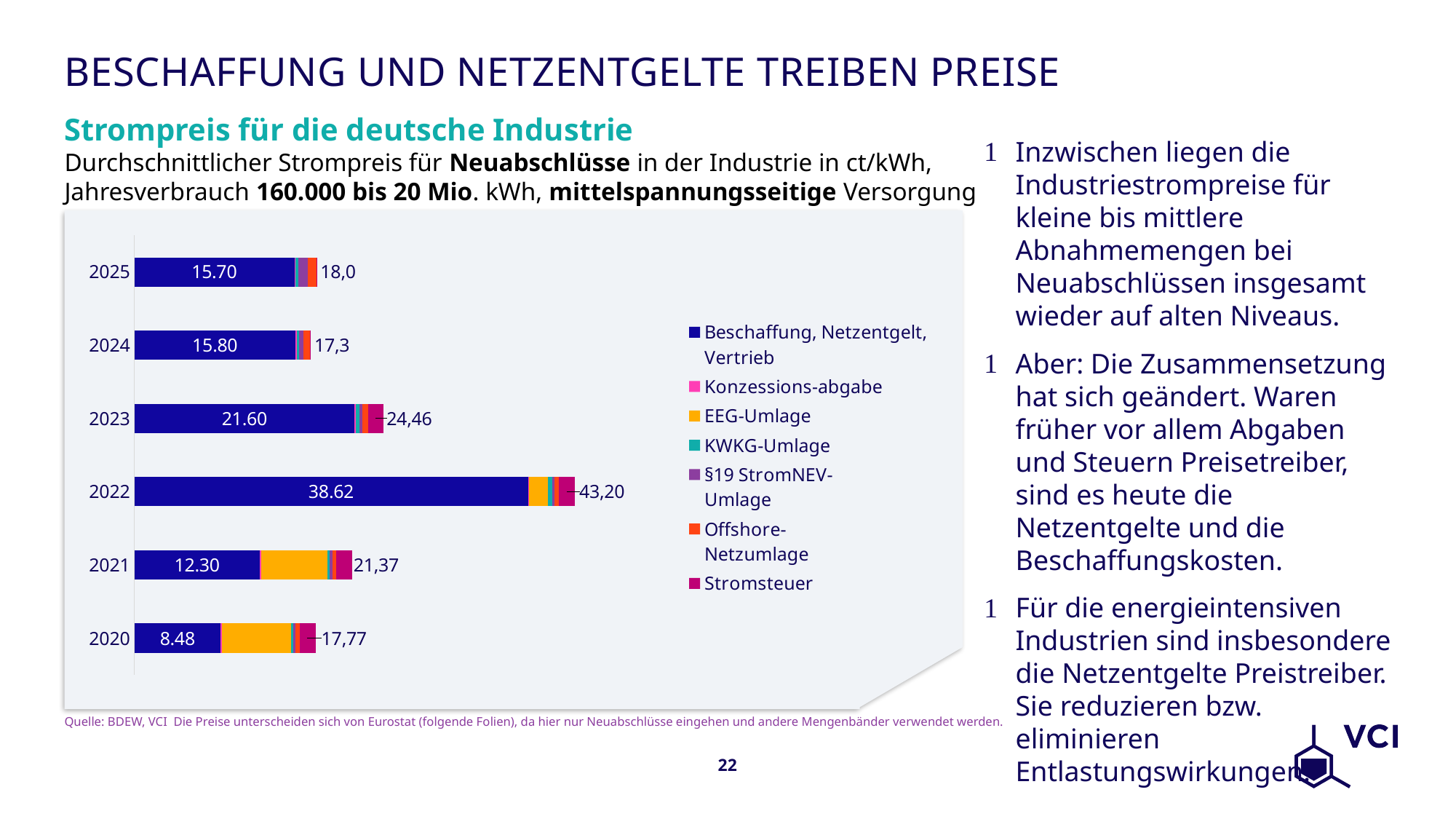
How many years are shown in the chart? 6 What kind of chart is shown on the slide? Stacked bar chart What is the total electricity price shown for 2023? 24,46 What is the total electricity price shown for 2025? 18,0 Is the 'Beschaffung, Netzentgelt, Vertrieb' segment larger in 2024 or in 2021? 2024 Which year has the highest total electricity price? 2022 What is the value of the 'Beschaffung, Netzentgelt, Vertrieb' segment for 2020? 8.48 What is the title of the chart? Strompreis für die deutsche Industrie Which year has the smallest 'Beschaffung, Netzentgelt, Vertrieb' segment? 2020 Which year has the lowest total electricity price? 2024 What is the value of the 'Beschaffung, Netzentgelt, Vertrieb' segment for 2022? 38.62 How many series does the legend list? 7